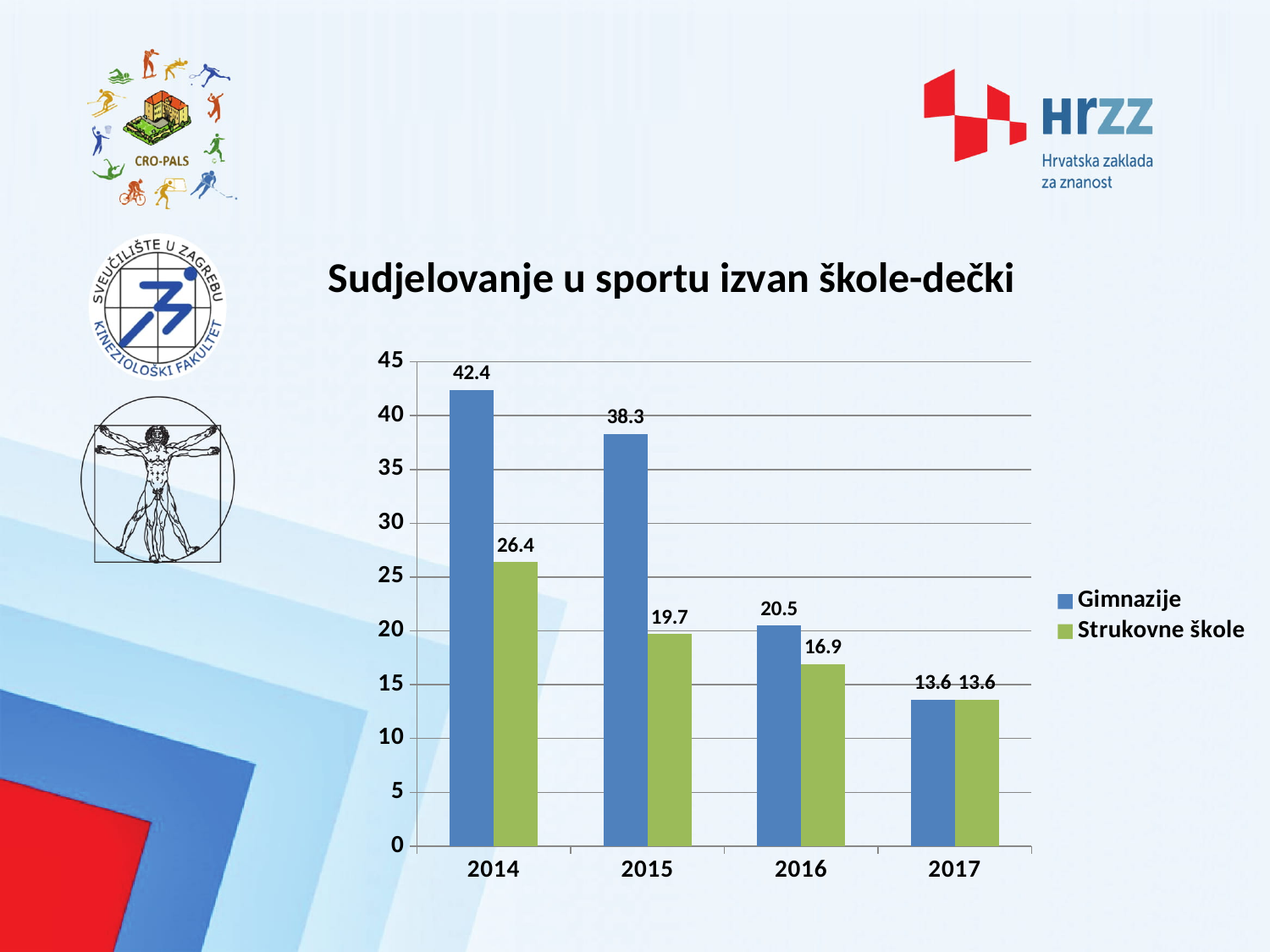
What is the difference between Gimnazije in 2015 and Gimnazije in 2016? 17.8 Which year has the highest value for Gimnazije? 2014 How many series does the legend list? 2 What is the difference between Gimnazije and Strukovne škole in 2014? 16 Which is larger in 2016, Gimnazije or Strukovne škole? Gimnazije What is the value for Strukovne škole in 2015? 19.7 Do the Gimnazije values rise or fall from 2014 to 2017? Fall What is the value for Gimnazije in 2014? 42.4 What kind of chart is shown on the slide? Bar chart How many years are shown on the x axis? 4 Which year has the lowest value for Strukovne škole? 2017 What is the value for Strukovne škole in 2017? 13.6